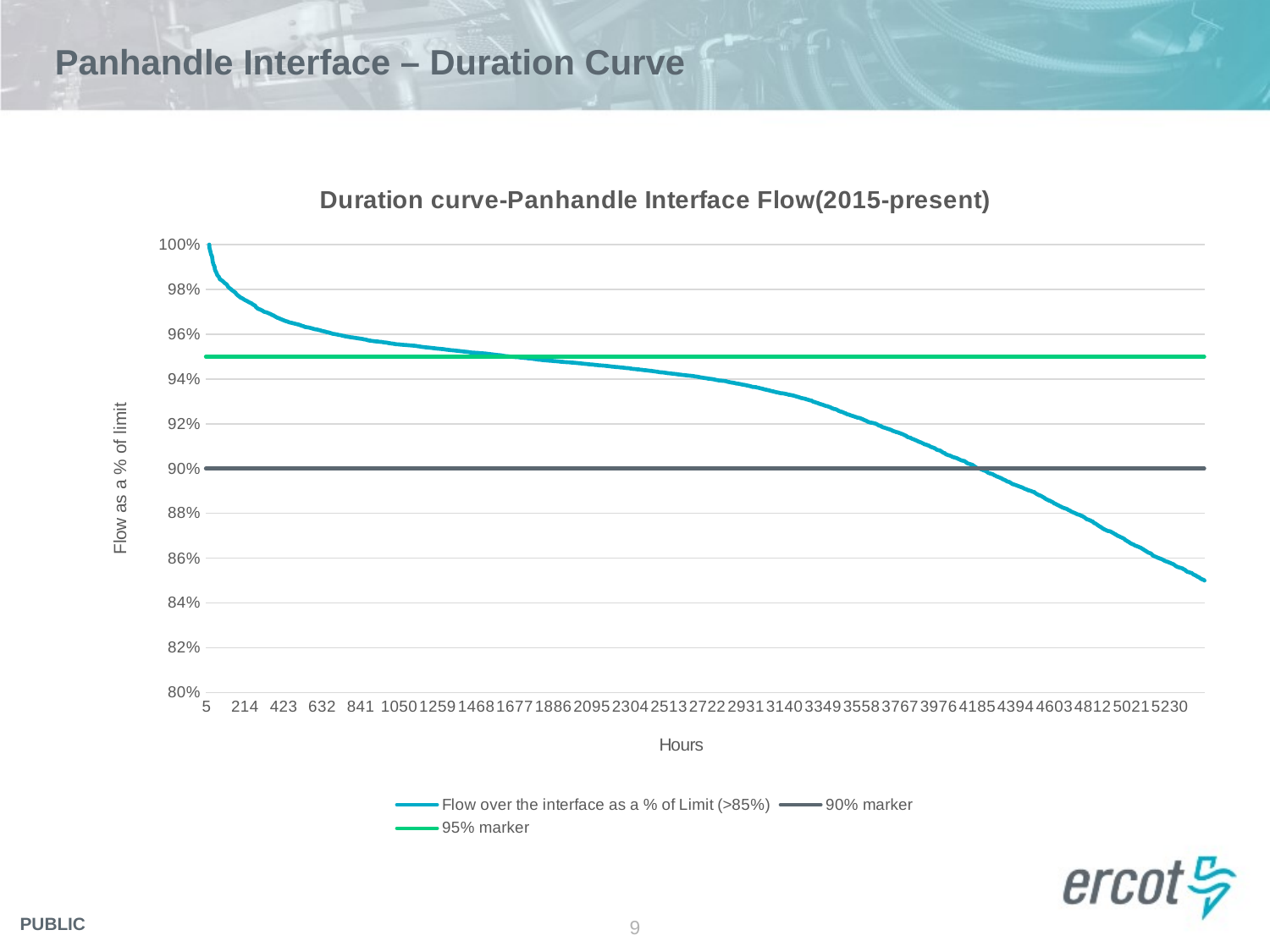
Is the flow value at hour 4394 greater or less than 90%? less Is the flow value at hour 1050 greater or less than 94%? greater What kind of chart is shown on the slide? line chart At hour 5230, which of the three series has the highest value? 95% marker Is the flow value at hour 5230 greater or less than 86%? less At hour 3140, is the flow line above or below the 95% marker? below Does the 'Flow over the interface as a % of Limit (>85%)' line rise or fall as hours increase along the x axis? fall What constant value does the '90% marker' series sit at? 90% What is the label of the y axis? Flow as a % of limit How many series does the legend list? 3 What is the title of the chart? Duration curve-Panhandle Interface Flow(2015-present) What constant value does the '95% marker' series sit at? 95%